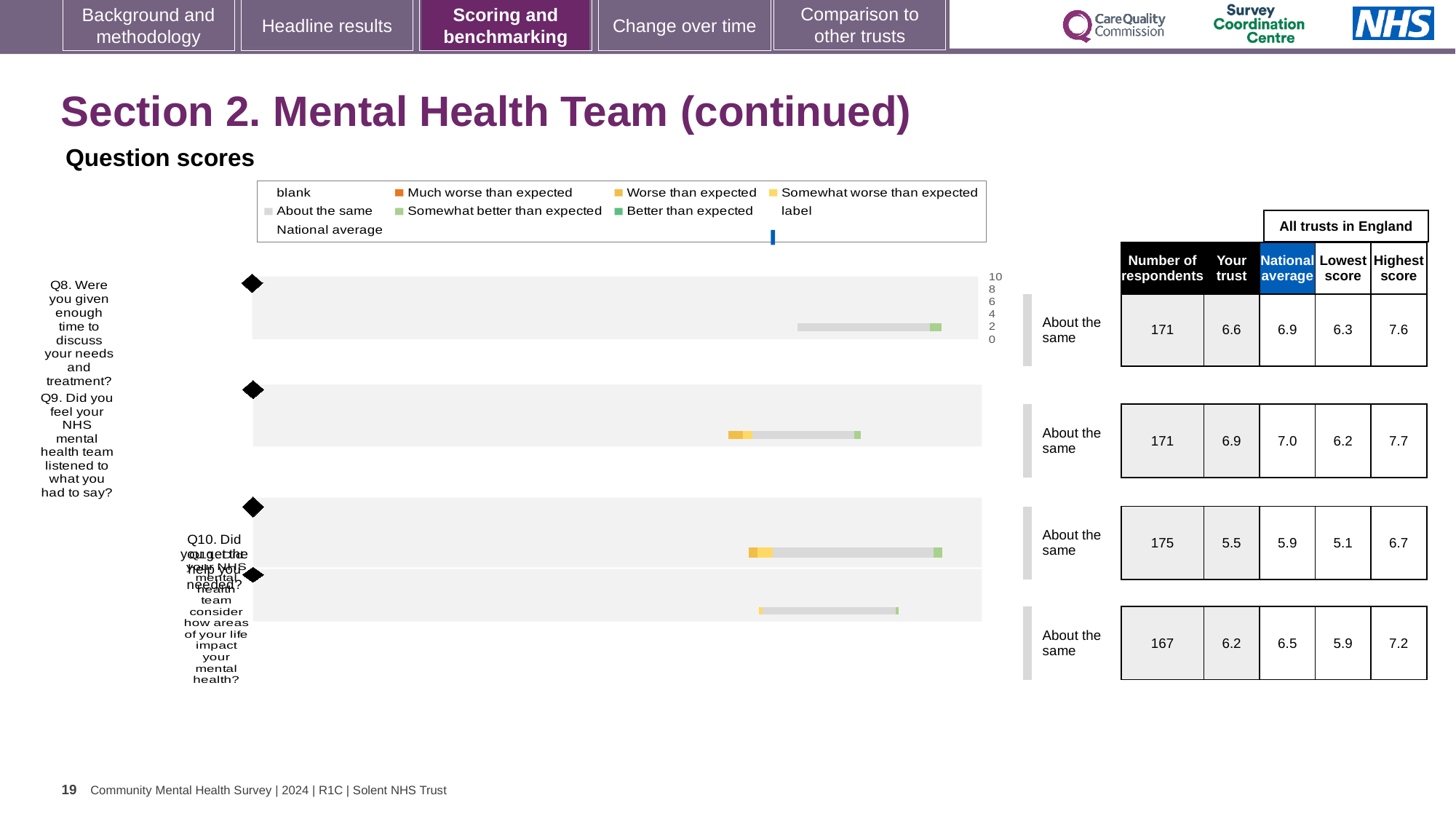
For Q10, which is larger: the trust's score or the national average? National average What kind of chart is used to show the question scores on this slide? bar chart What is the highest score among all trusts in England for Q11? 7.2 What is the 'Your trust' score for Q8 (Were you given enough time to discuss your needs and treatment?)? 6.6 How many questions (bars) are plotted in the question scores chart? 4 How many respondents answered Q10 (Did you get the help you needed?)? 175 What is the national average score for Q9 (Did you feel your NHS mental health team listened to what you had to say?)? 7.0 Which question has the lowest 'Your trust' score? Q10 What is the difference between the highest score (7.6) and the lowest score (6.3) for Q8? 1.3 Which question has the highest 'Your trust' score? Q9 Which colour in the legend represents 'Much worse than expected'? Orange What benchmark category is shown for Q9? About the same